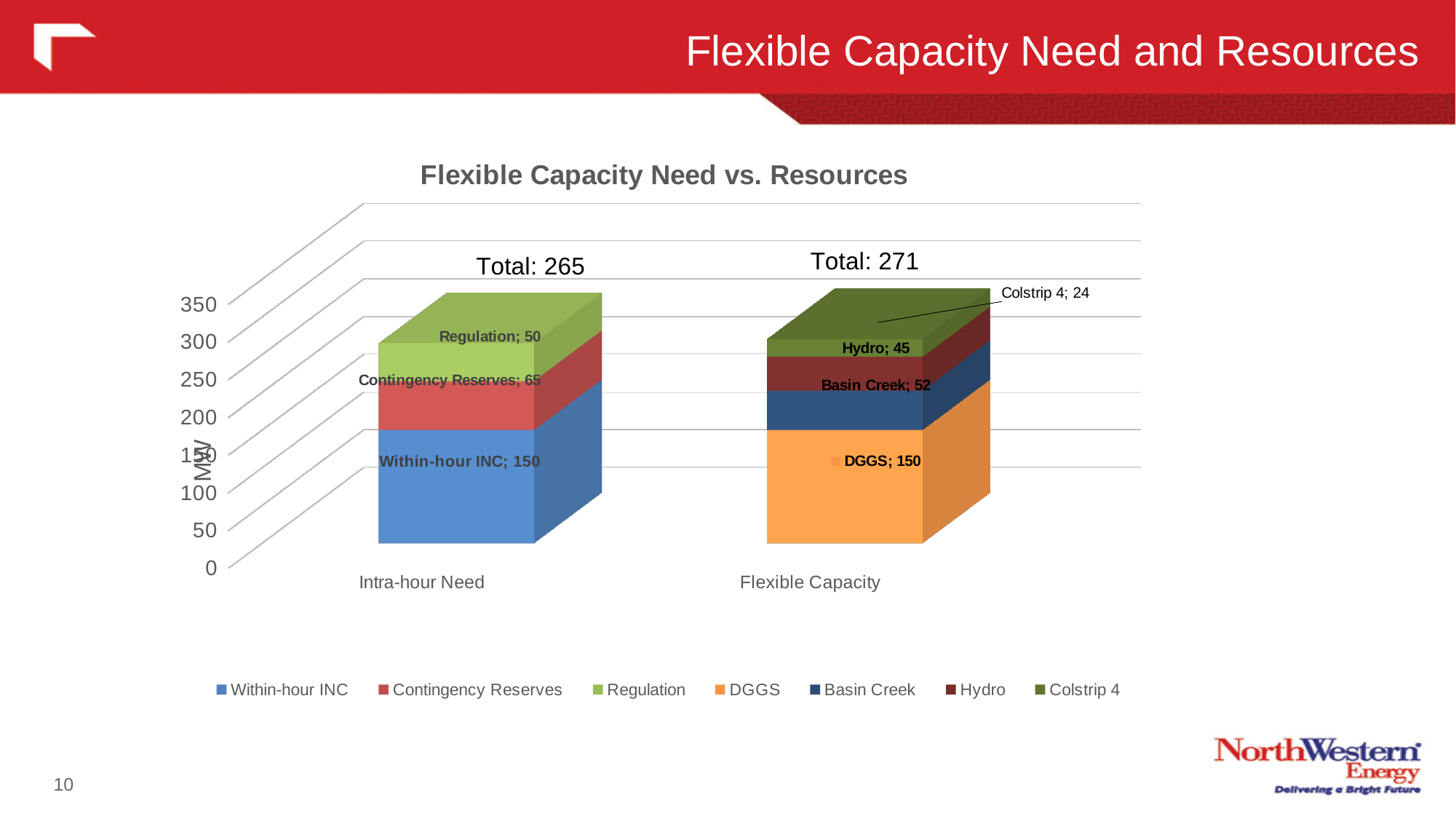
What is the value of Regulation in the Intra-hour Need bar? 50 How many categories are shown on the x axis? 2 What is the value of Basin Creek in the Flexible Capacity bar? 52 What is the value of Colstrip 4 in the Flexible Capacity bar? 24 What is the value of Within-hour INC in the Intra-hour Need bar? 150 What is the difference between the Hydro value and the Colstrip 4 value in the Flexible Capacity bar? 21 What is the value of Contingency Reserves in the Intra-hour Need bar? 65 What is the total of the Flexible Capacity stacked bar? 271 What kind of chart is shown on the slide? Stacked bar chart What is the total of the Intra-hour Need stacked bar? 265 How many series does the legend list? 7 Which is larger in the Flexible Capacity bar: Basin Creek or Hydro? Basin Creek